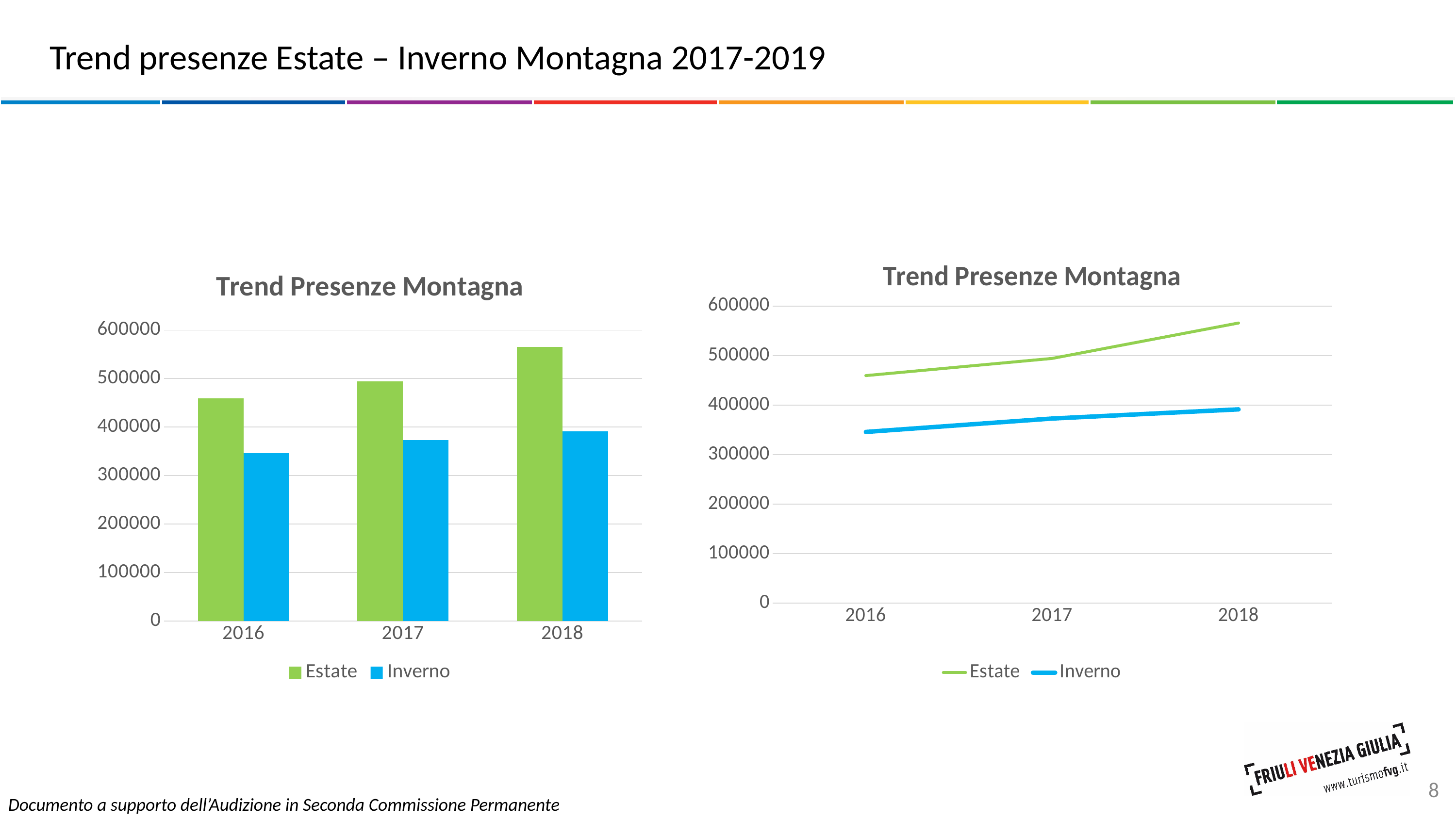
In the left bar chart, which is larger in 2017, Estate or Inverno? Estate In the left bar chart, is the Estate value for 2018 greater or less than 500000? greater In the left bar chart, which year has the highest Estate value? 2018 What is the title of the right line chart? Trend Presenze Montagna In the right line chart, how many years are shown on the x axis? 3 What kind of chart is the right chart on the slide? line chart In the right line chart, does the Estate line rise or fall from 2016 to 2018? rises In the left bar chart, how many series does the legend list? 2 In the right line chart, is the Inverno value for 2016 greater or less than 400000? less What kind of chart is the left chart on the slide? bar chart In the left bar chart, which year has the lowest Inverno value? 2016 In the left bar chart, what colour are the Inverno bars? blue